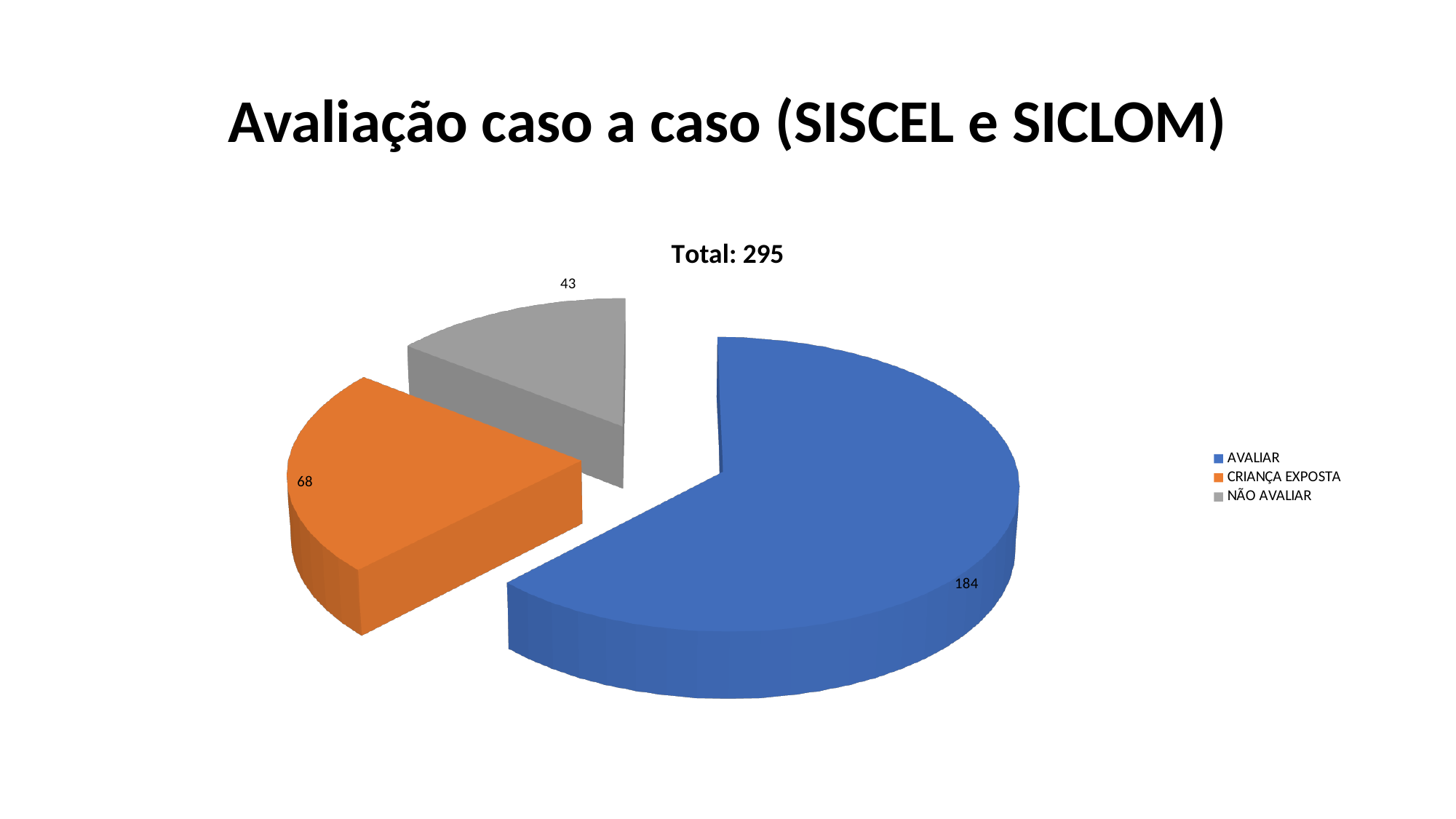
What is the value for AVALIAR in the pie chart? 184 What is the total of all slices in the pie chart? 295 What is the title shown above the pie chart? Total: 295 Which category has the largest slice of the pie chart? AVALIAR What is the value for NÃO AVALIAR in the pie chart? 43 How many slices does the pie chart have? 3 Which category has the smallest slice of the pie chart? NÃO AVALIAR What kind of chart is shown on the slide? Pie chart Which is larger, the value for CRIANÇA EXPOSTA or the value for NÃO AVALIAR? CRIANÇA EXPOSTA What is the value for CRIANÇA EXPOSTA in the pie chart? 68 What is the difference between the values for AVALIAR and CRIANÇA EXPOSTA? 116 What is the difference between the values for CRIANÇA EXPOSTA and NÃO AVALIAR? 25